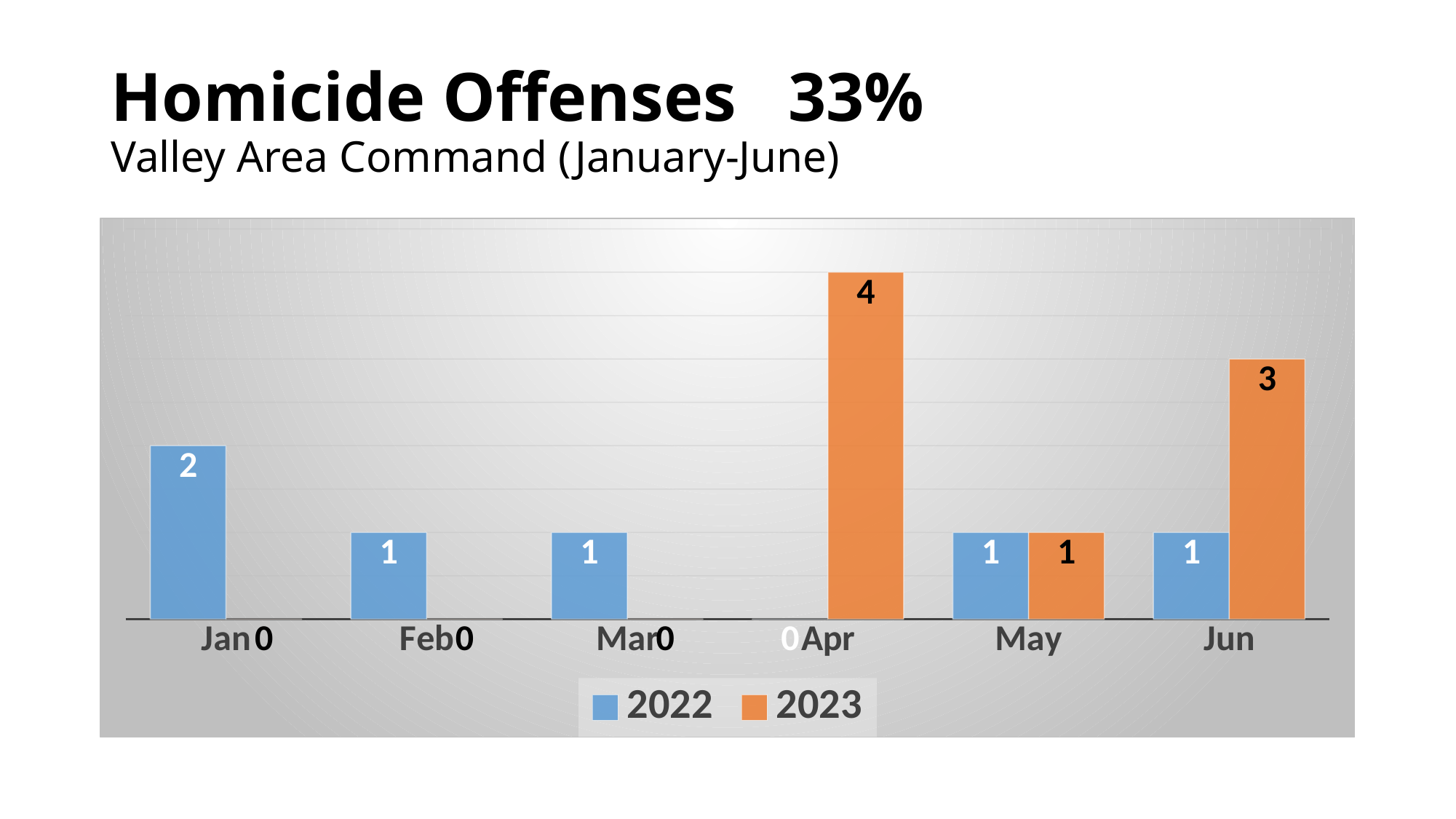
What is the 2022 value for Apr? 0 What kind of chart is shown on the slide? Bar chart How many series does the legend list? 2 Which is larger for Apr, the 2022 value or the 2023 value? 2023 What is the 2023 value for Feb? 0 How many months are shown on the x axis? 6 Which month has the highest 2023 value? Apr What is the 2022 value for Jan? 2 What is the 2023 value for Apr? 4 What is the difference between the 2023 and 2022 values for Jun? 2 What is the 2023 value for Jun? 3 Which month has the highest 2022 value? Jan